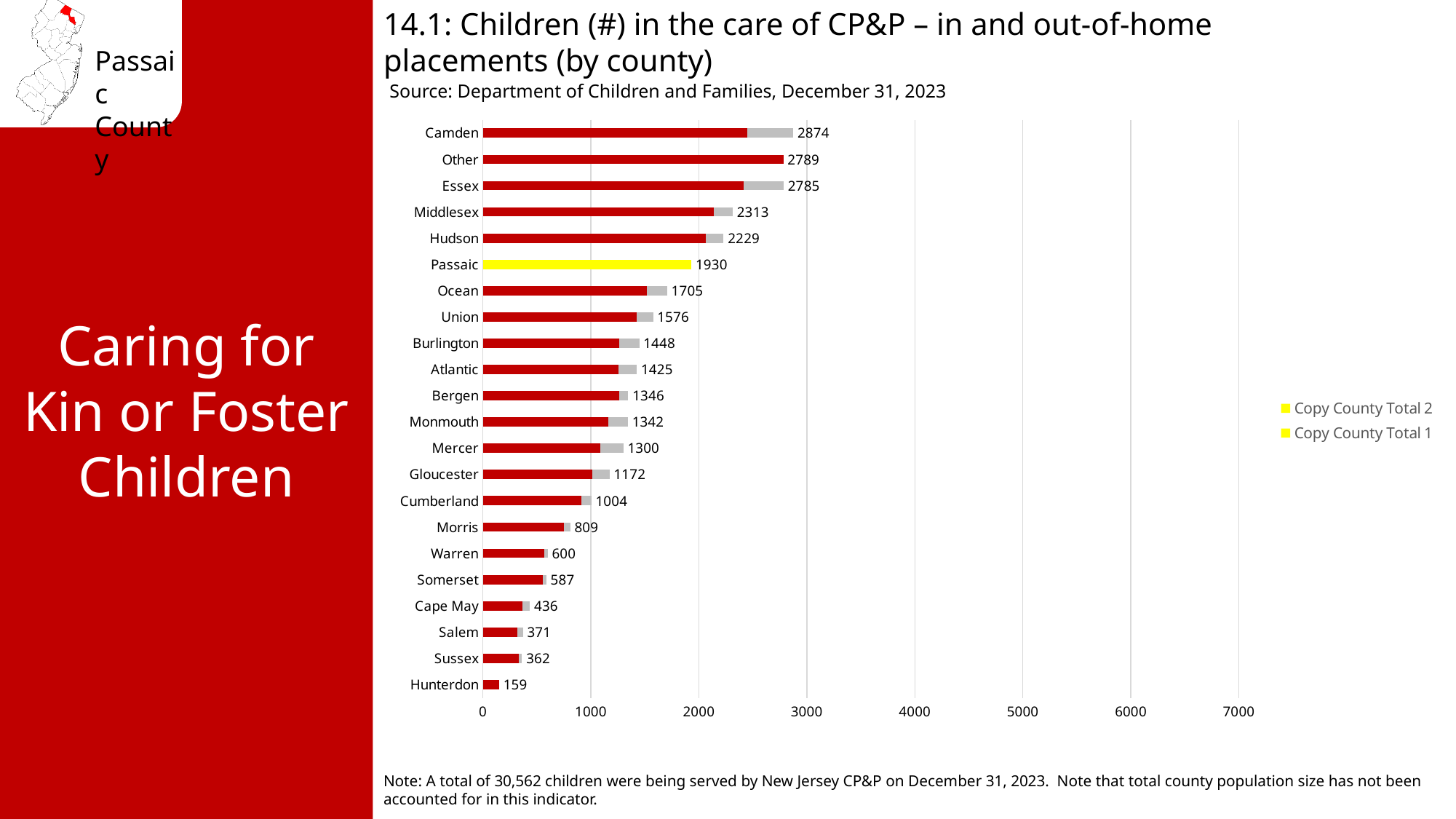
What is the total number of children in the care of CP&P for Camden? 2874 Is the total for Middlesex greater or less than 2000? greater What is the total number of children in the care of CP&P for Passaic? 1930 What is the difference between the totals for Camden and Passaic? 944 What kind of chart is shown on the slide? Bar chart Which has a larger total, Ocean or Union? Ocean How many counties (categories) are shown on the chart? 22 How many series does the legend list? 2 Which county has the highest total number of children in the care of CP&P? Camden Which county has the lowest total number of children in the care of CP&P? Hunterdon What colour is the bar for Passaic? Yellow What is the total number of children in the care of CP&P for Hunterdon? 159